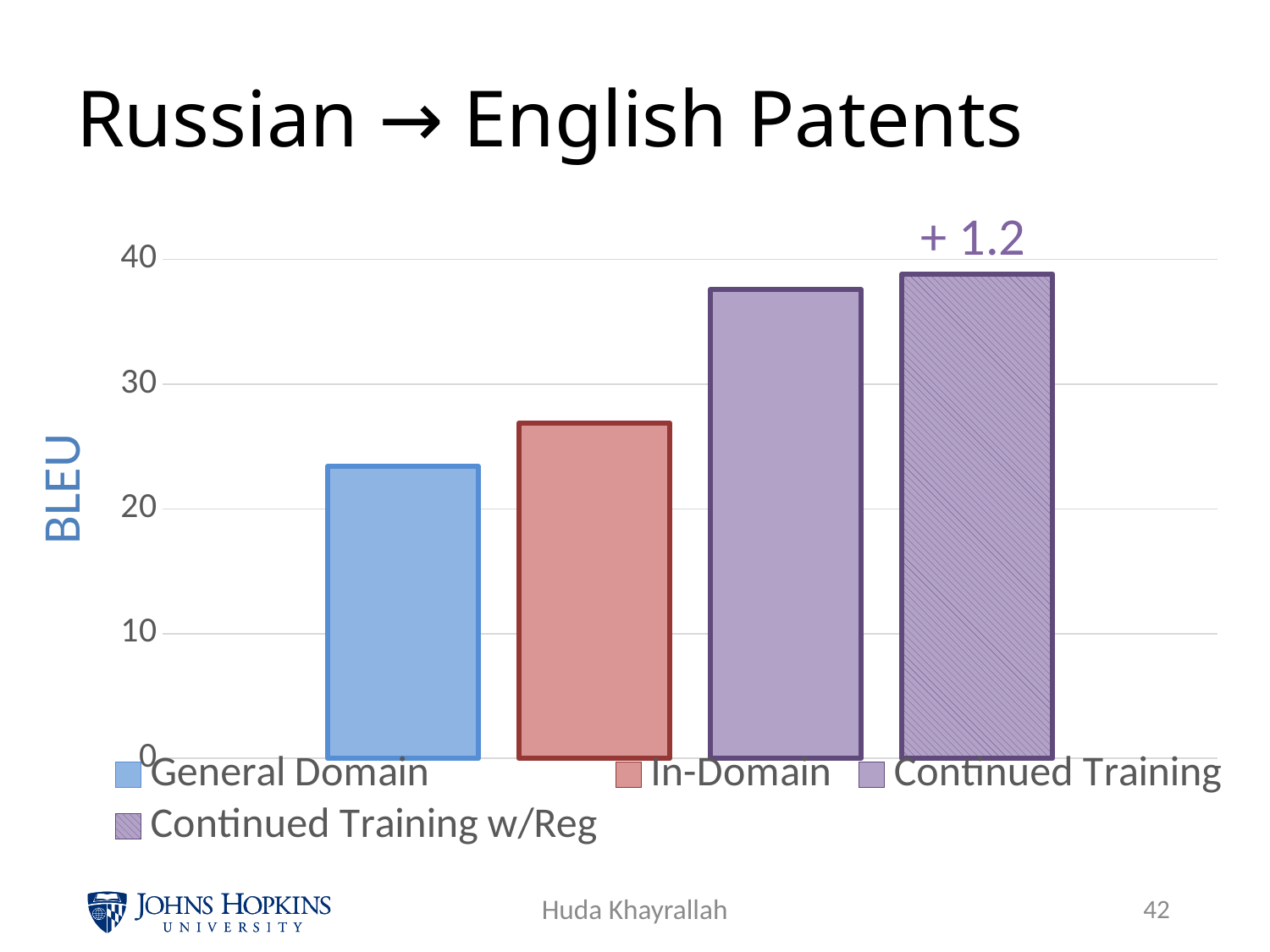
How many bars are plotted in the chart? 4 Is the BLEU score for Continued Training greater or less than 30? greater Which series has the highest BLEU score? Continued Training w/Reg Do the BLEU scores rise or fall from left to right across the bars? rise Is the BLEU score for General Domain greater or less than 30? less Which series has the lowest BLEU score? General Domain Which has a higher BLEU score, In-Domain or Continued Training? Continued Training Which has a higher BLEU score, General Domain or In-Domain? In-Domain Is the BLEU score for Continued Training w/Reg greater or less than 40? less What improvement is annotated above the Continued Training w/Reg bar? + 1.2 What kind of chart is shown on the slide? bar chart How many series does the legend list? 4